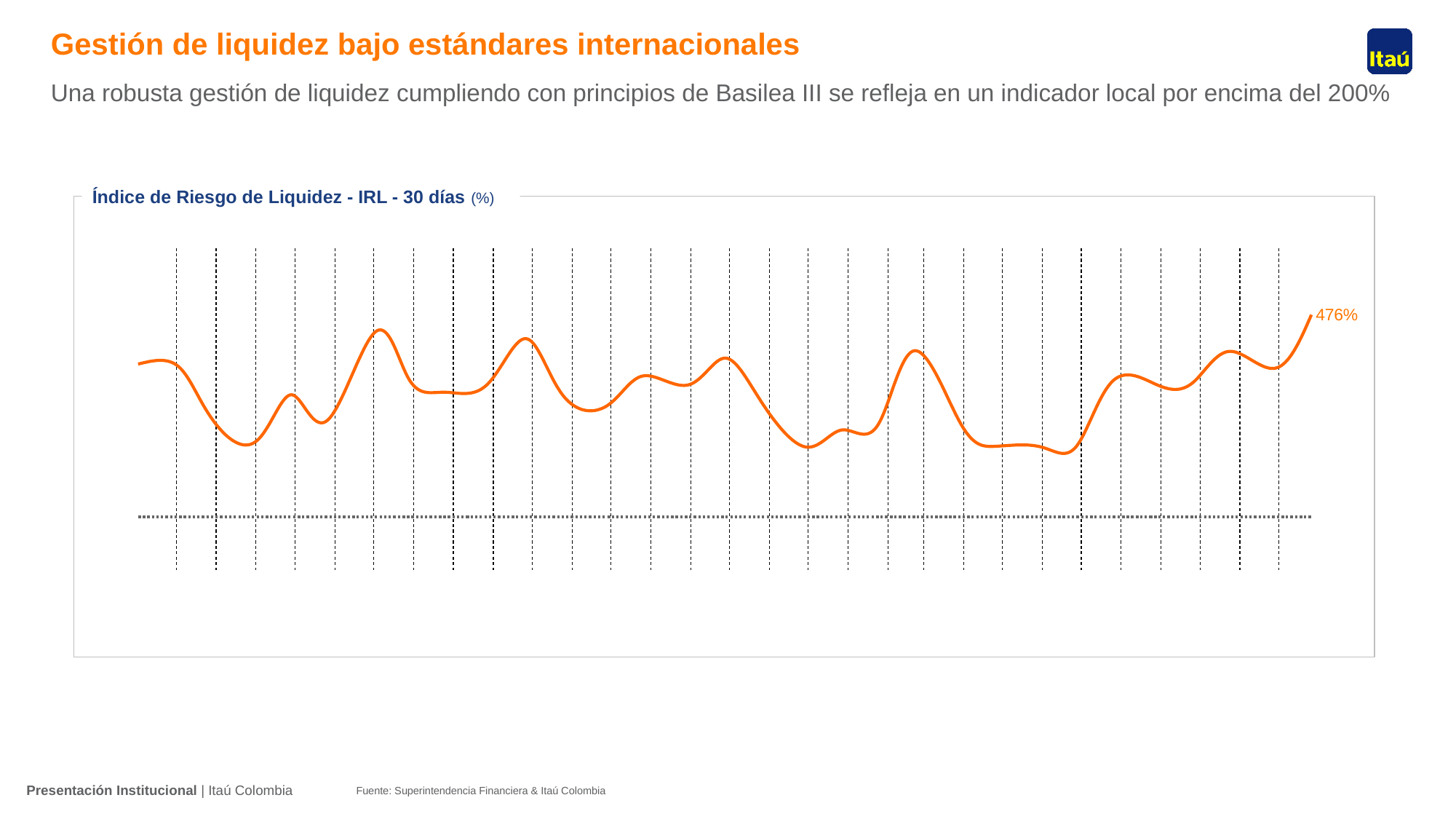
Is the final value of the line greater or less than 400%? greater How many lines (series) are plotted on the chart? 2 What kind of chart is shown on the slide? line chart Which point on the line has the highest value? the last (most recent) point, 476% What colour is the plotted line? orange Does the line end higher or lower than where it starts? higher What is the title of the chart? Índice de Riesgo de Liquidez - IRL - 30 días (%) What is the value of the last (most recent) data point on the line? 476%